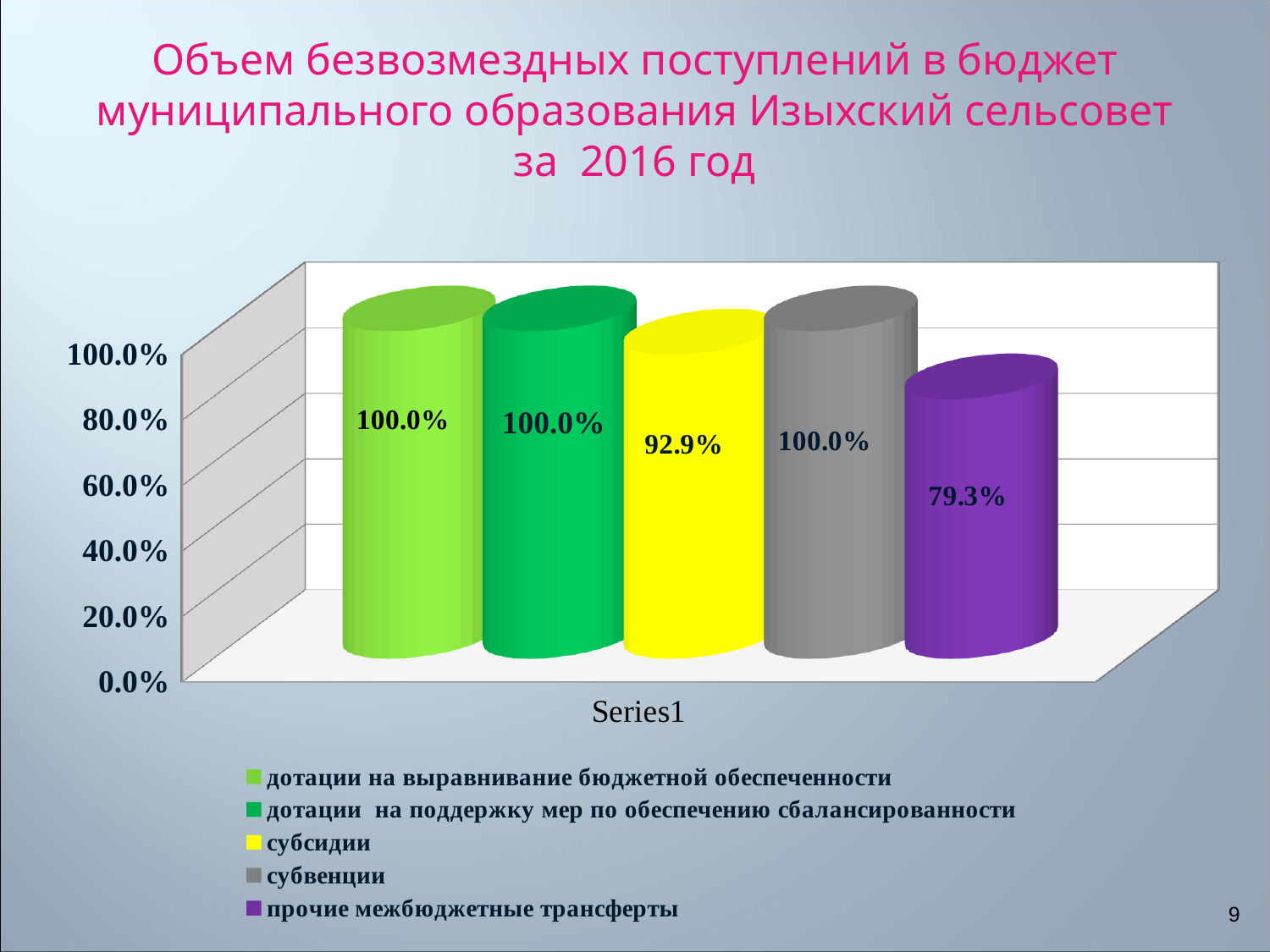
What colour is the bar for субсидии? yellow Which is larger, the value for субсидии or the value for прочие межбюджетные трансферты? субсидии Is the value for прочие межбюджетные трансферты greater or less than 80.0%? less What is the value for субсидии? 92.9% What is the difference between the values for субвенции and субсидии? 7.1% What is the value for субвенции? 100.0% What is the difference between the values for субсидии and прочие межбюджетные трансферты? 13.6% What is the value for прочие межбюджетные трансферты? 79.3% Which legend entry has the lowest value? прочие межбюджетные трансферты What is the value for дотации на выравнивание бюджетной обеспеченности? 100.0% How many series does the legend list? 5 What kind of chart is shown on the slide? bar chart